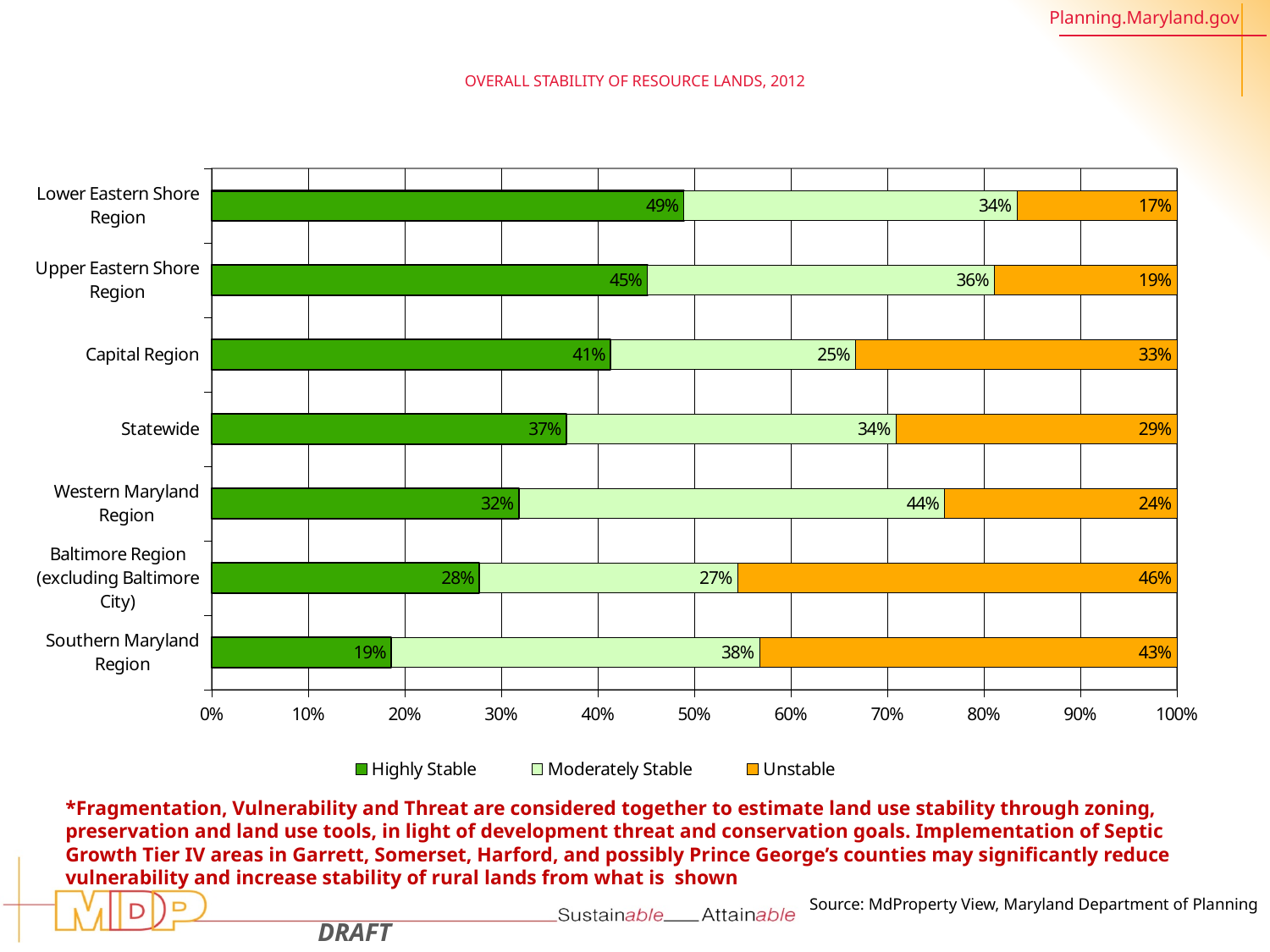
What is the difference between the Unstable values for the Capital Region and Statewide? 4% What is the Highly Stable value for the Capital Region? 41% Which region has the highest Highly Stable value? Lower Eastern Shore Region How many regions (categories) are shown on the chart? 7 Which region has the lowest Highly Stable value? Southern Maryland Region How many series does the legend list? 3 What is the title of the chart? OVERALL STABILITY OF RESOURCE LANDS, 2012 Which is larger: the Moderately Stable value for the Upper Eastern Shore Region or for the Capital Region? Upper Eastern Shore Region Which region has the highest Unstable value? Baltimore Region (excluding Baltimore City) What is the Unstable value for the Baltimore Region (excluding Baltimore City)? 46% What is the Moderately Stable value for the Western Maryland Region? 44% What kind of chart is shown on the slide? Stacked bar chart